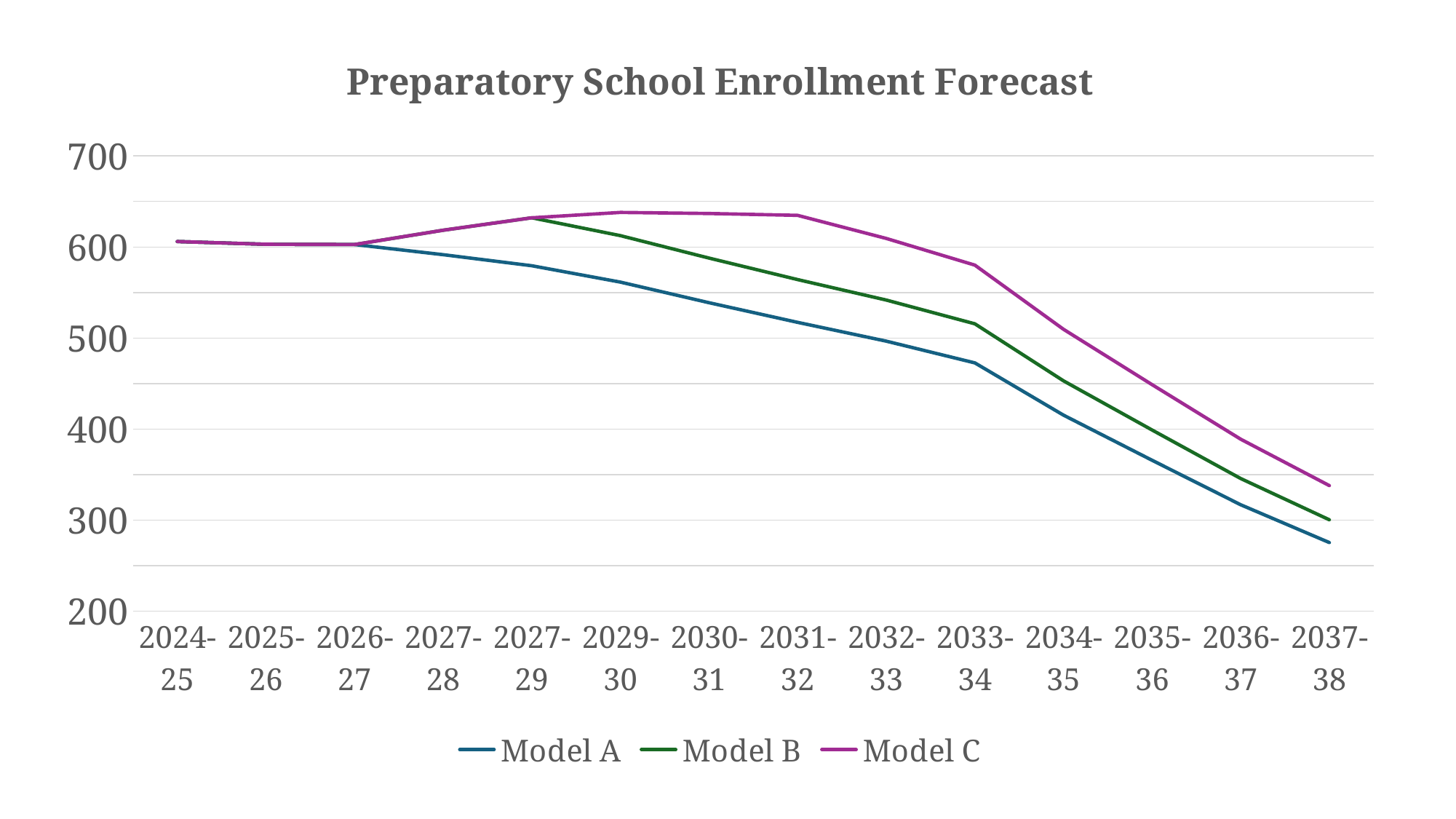
What kind of chart is shown on the slide? line chart Which model has the lowest value in 2037-38? Model A Is the value for Model A in 2033-34 greater or less than 500? less Which series is drawn in purple? Model C Is the value for Model A in 2037-38 greater or less than 300? less How many school years are shown on the x axis? 14 Which model has the highest value in 2037-38? Model C How many series does the legend list? 3 In 2033-34, which is larger, Model B or Model A? Model B What is the title of the chart? Preparatory School Enrollment Forecast Does Model A rise or fall from 2026-27 to 2037-38? fall Is the value for Model C in 2029-30 greater or less than 600? greater